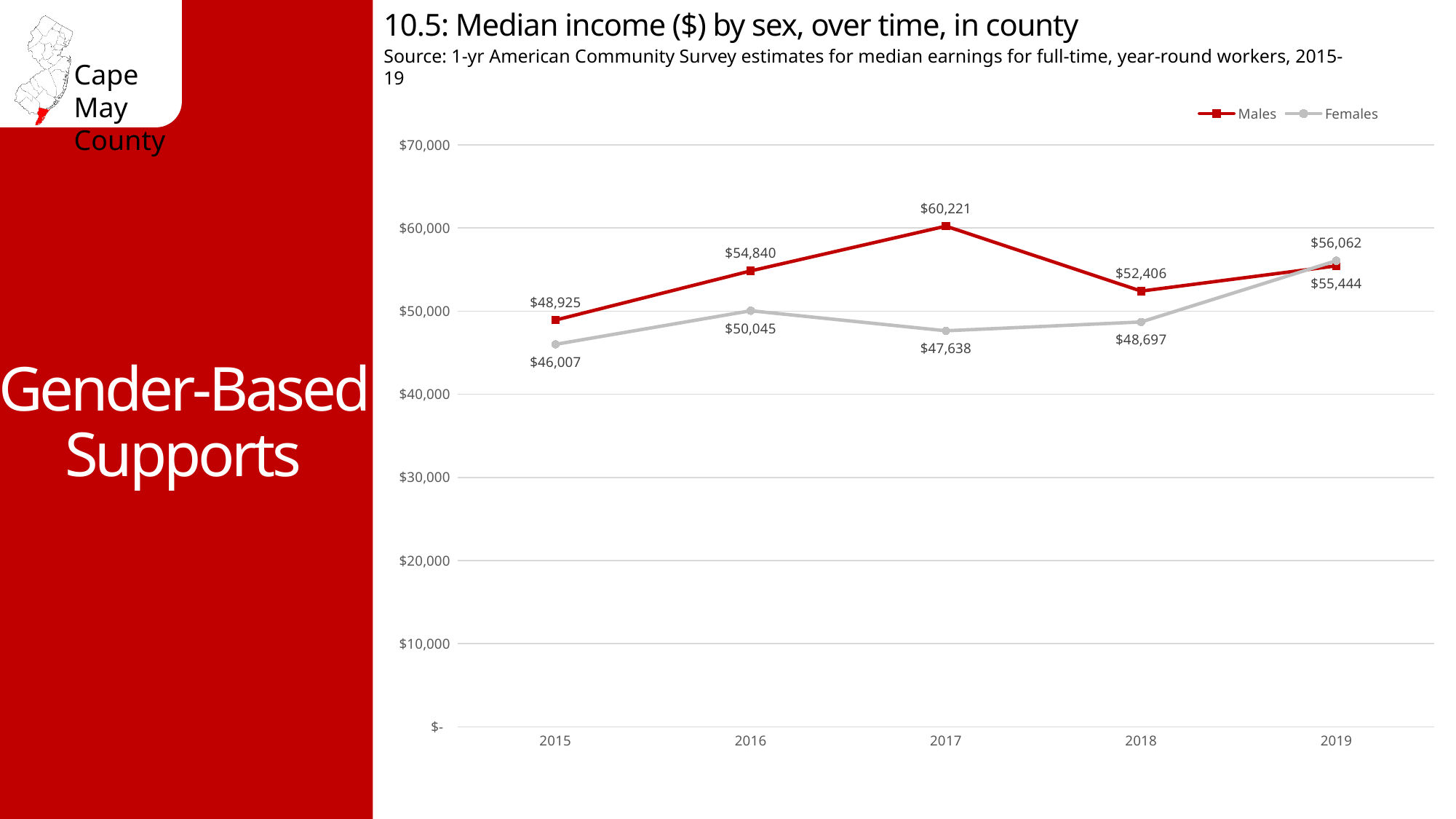
What kind of chart is shown on the slide? line chart Which series has the higher median income in 2019, Males or Females? Females How many series does the legend list? 2 In which year is the median income for Males highest? 2017 How many years are shown on the x axis? 5 What is the median income for Females in 2019? $56,062 What is the median income for Males in 2017? $60,221 In which year is the median income for Females lowest? 2015 What is the median income for Males in 2018? $52,406 Is the median income for Females in 2017 greater or less than $50,000? less What is the median income for Females in 2015? $46,007 What is the difference between the Males and Females median income in 2017? $12,583